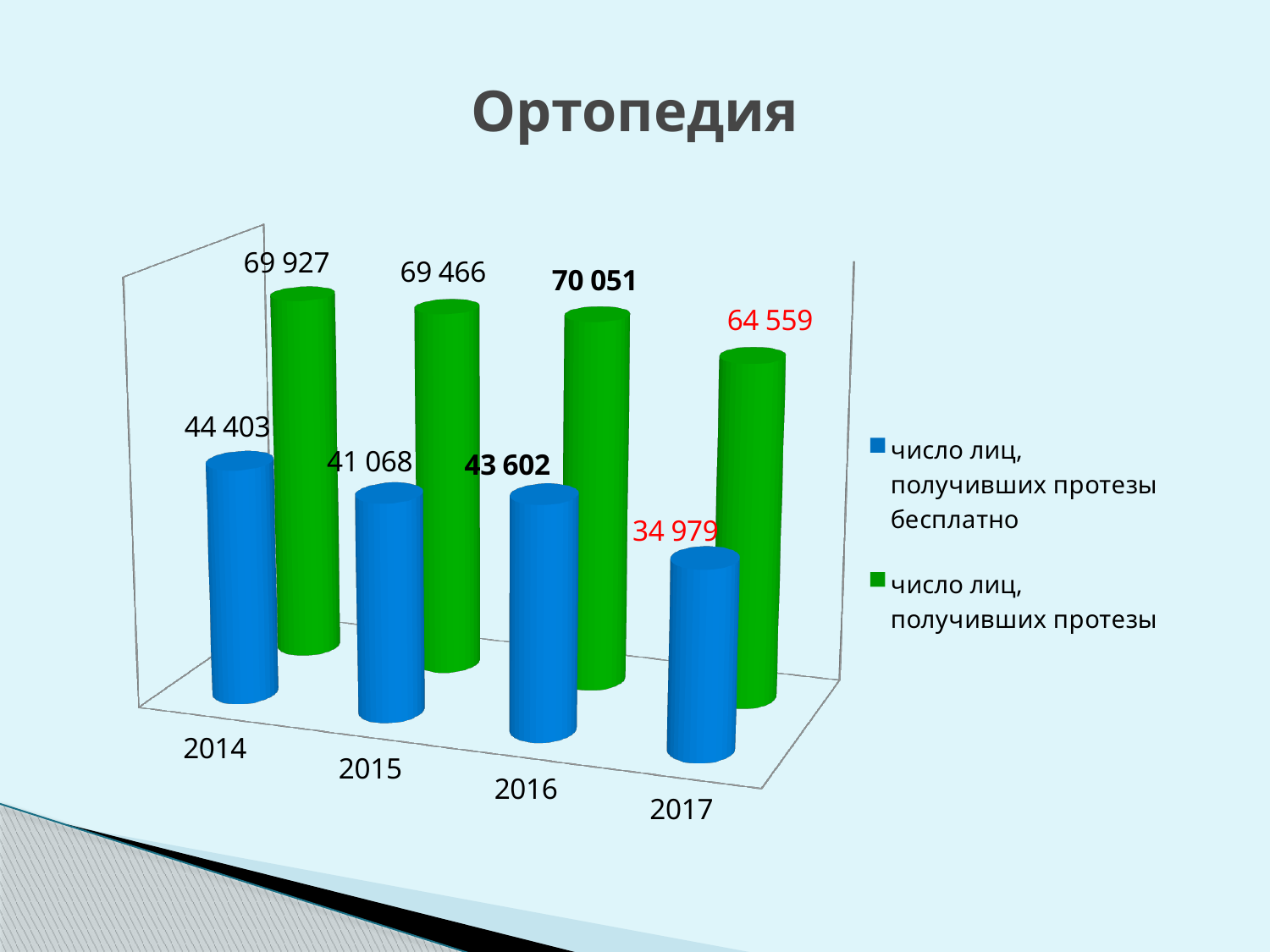
In which year is 'число лиц, получивших протезы' highest? 2016 What is the difference between 'число лиц, получивших протезы' and 'число лиц, получивших протезы бесплатно' in 2015? 28 398 What is the title of the chart? Ортопедия What is the value for 'число лиц, получивших протезы' in 2016? 70 051 How many years are shown on the x axis? 4 Which colour represents 'число лиц, получивших протезы бесплатно' in the legend? blue How many series does the legend list? 2 Which is larger: 'число лиц, получивших протезы бесплатно' in 2016 or in 2017? 2016 What is the value for 'число лиц, получивших протезы бесплатно' in 2014? 44 403 In which year is 'число лиц, получивших протезы бесплатно' lowest? 2017 What is the value for 'число лиц, получивших протезы' in 2017? 64 559 What type of chart is shown on the slide? bar chart